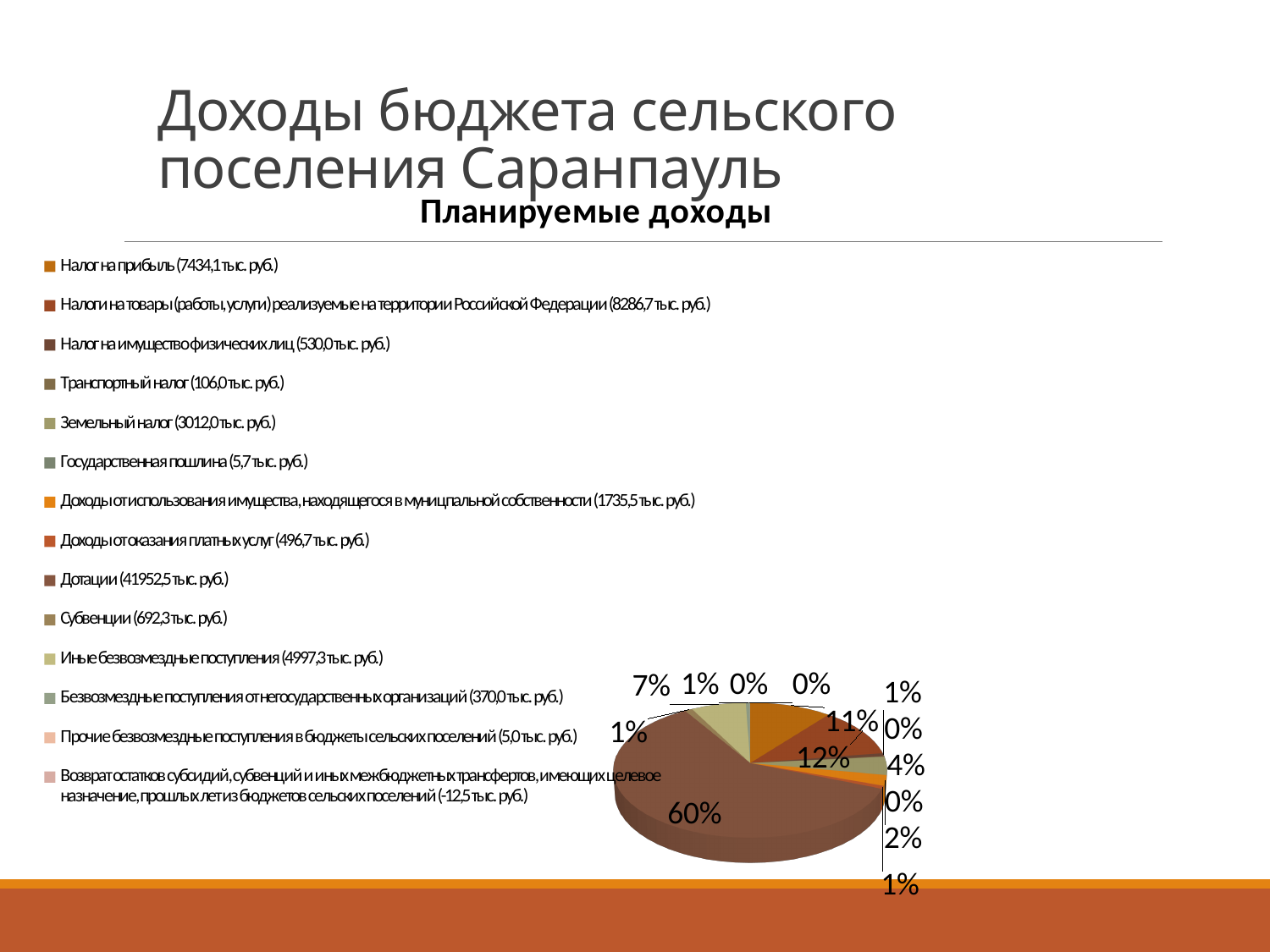
What kind of chart is shown on the slide? pie chart Which category accounts for the largest share of the pie? Дотации What amount is given in the legend for Земельный налог? 3012,0 тыс. руб. Which is larger according to the legend: Земельный налог or Налог на имущество физических лиц? Земельный налог What amount is given in the legend for Дотации? 41952,5 тыс. руб. What amount is given in the legend for Налог на прибыль? 7434,1 тыс. руб. Which category has the smallest amount in the legend? Возврат остатков субсидий, субвенций и иных межбюджетных трансфертов, имеющих целевое назначение, прошлых лет из бюджетов сельских поселений What is the difference between the legend amounts for Налоги на товары (работы, услуги) реализуемые на территории Российской Федерации and Налог на прибыль? 852,6 тыс. руб. What is the title of the chart? Планируемые доходы What amount is given in the legend for Субвенции? 692,3 тыс. руб. How many categories does the chart's legend list? 14 What is the largest percentage label shown on the pie chart? 60%